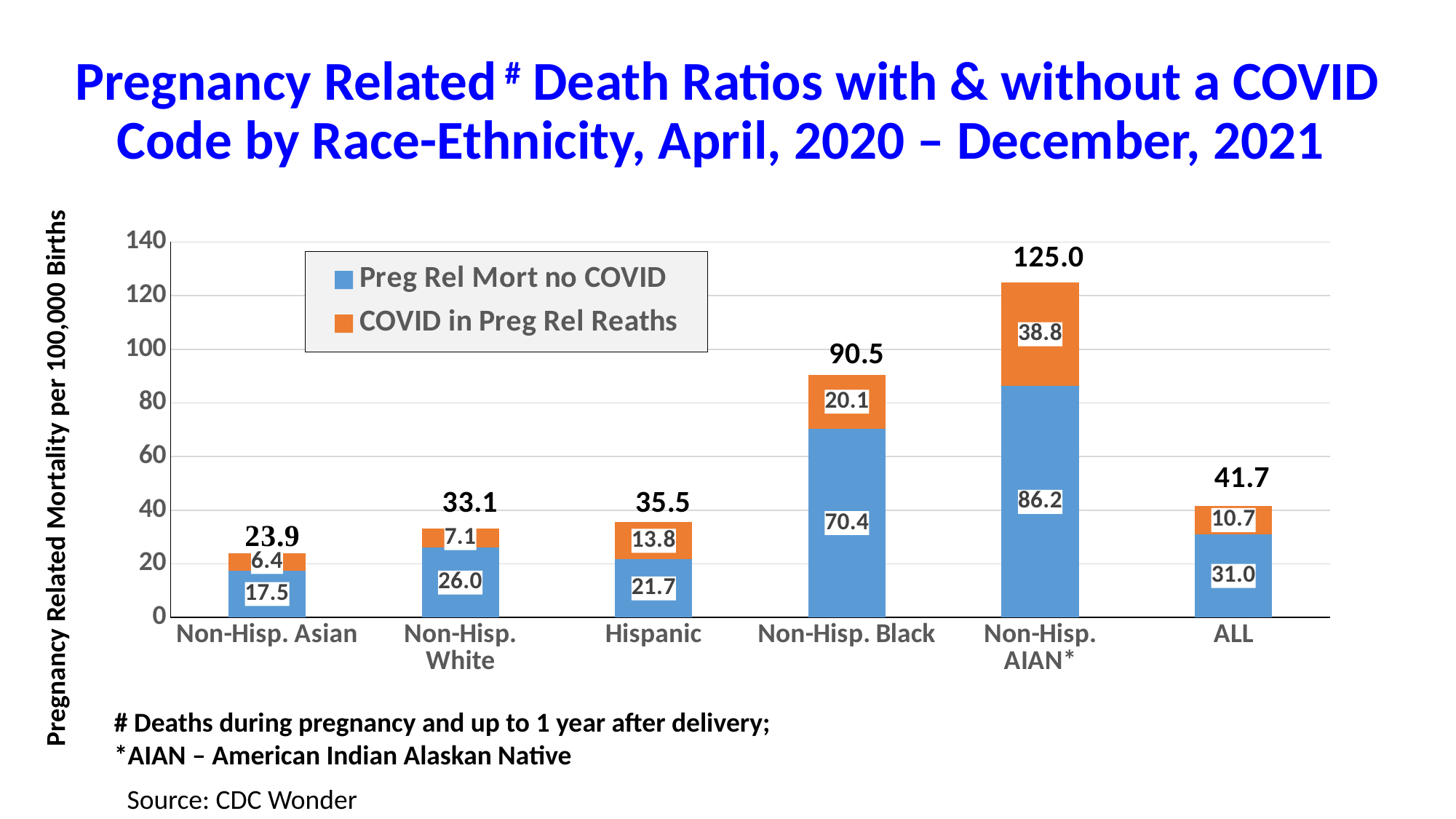
What is the label of the y axis? Pregnancy Related Mortality per 100,000 Births How many series does the legend list? 2 What is the difference between the 'COVID in Preg Rel Reaths' values for Non-Hisp. AIAN* and Non-Hisp. Black? 18.7 How many categories are shown on the x axis? 6 Which category has the lowest total pregnancy related mortality? Non-Hisp. Asian Which category has the highest total pregnancy related mortality? Non-Hisp. AIAN* What is the 'COVID in Preg Rel Reaths' value for Hispanic? 13.8 What is the total pregnancy related mortality shown above the Non-Hisp. AIAN* bar? 125.0 What is the 'Preg Rel Mort no COVID' value for Non-Hisp. Black? 70.4 What kind of chart is shown on the slide? Stacked bar chart Which is larger, the 'Preg Rel Mort no COVID' value for Non-Hisp. White or for Hispanic? Non-Hisp. White Is the total for Non-Hisp. Black greater or less than 80? greater